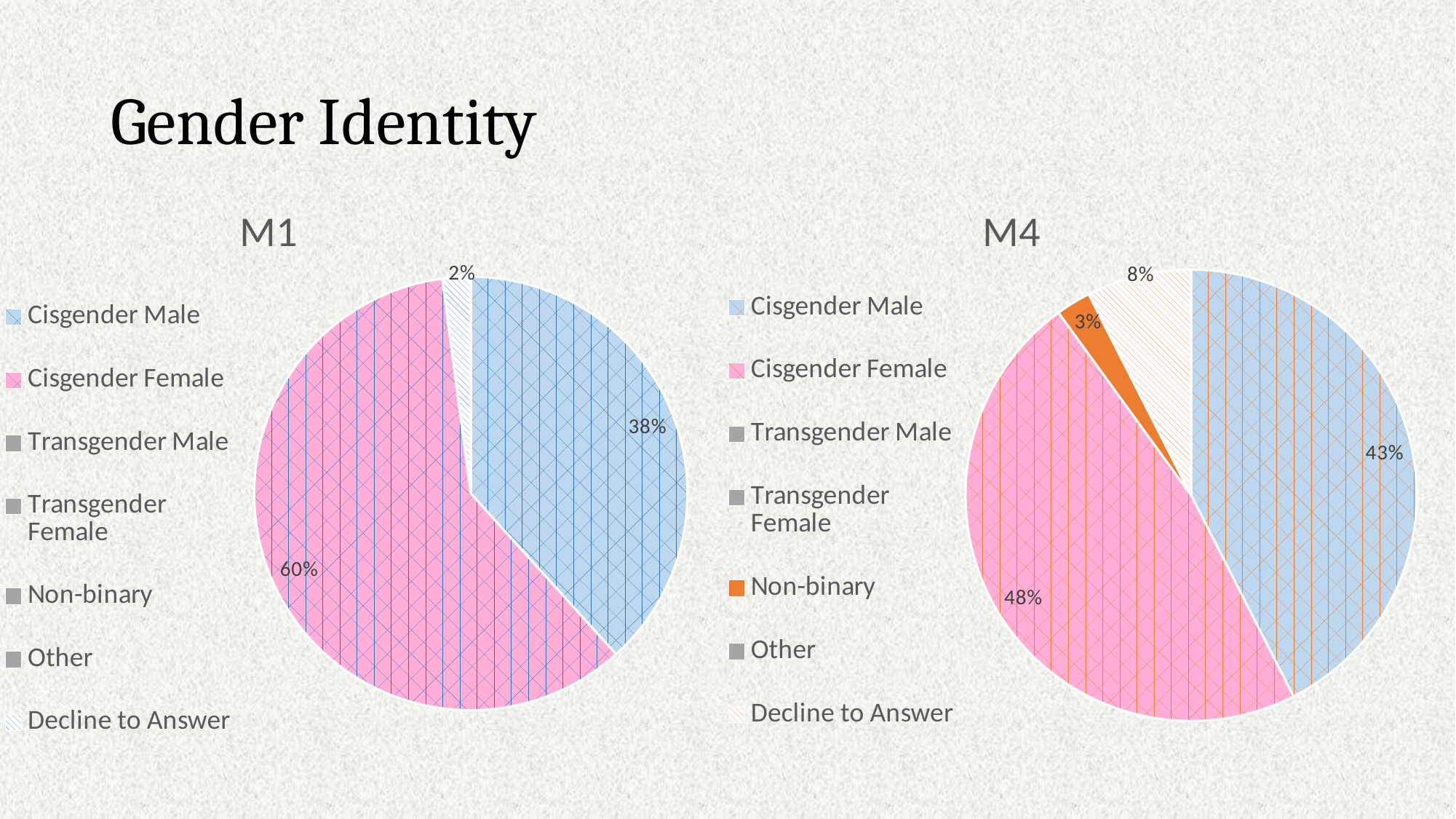
In the M1 chart, what share of the pie is Decline to Answer? 2% In the M4 chart, what share of the pie is Cisgender Male? 43% In the M4 chart, what share of the pie is Non-binary? 3% How many entries does the legend of the M1 chart list? 7 What kind of chart is the M4 chart? Pie chart In the M4 chart, which category has the largest slice? Cisgender Female In the M1 chart, what is the difference between the Cisgender Female and Cisgender Male shares? 22% In the M1 chart, which category has the smallest visible slice? Decline to Answer In the M4 chart, which is larger, Cisgender Female or Cisgender Male? Cisgender Female